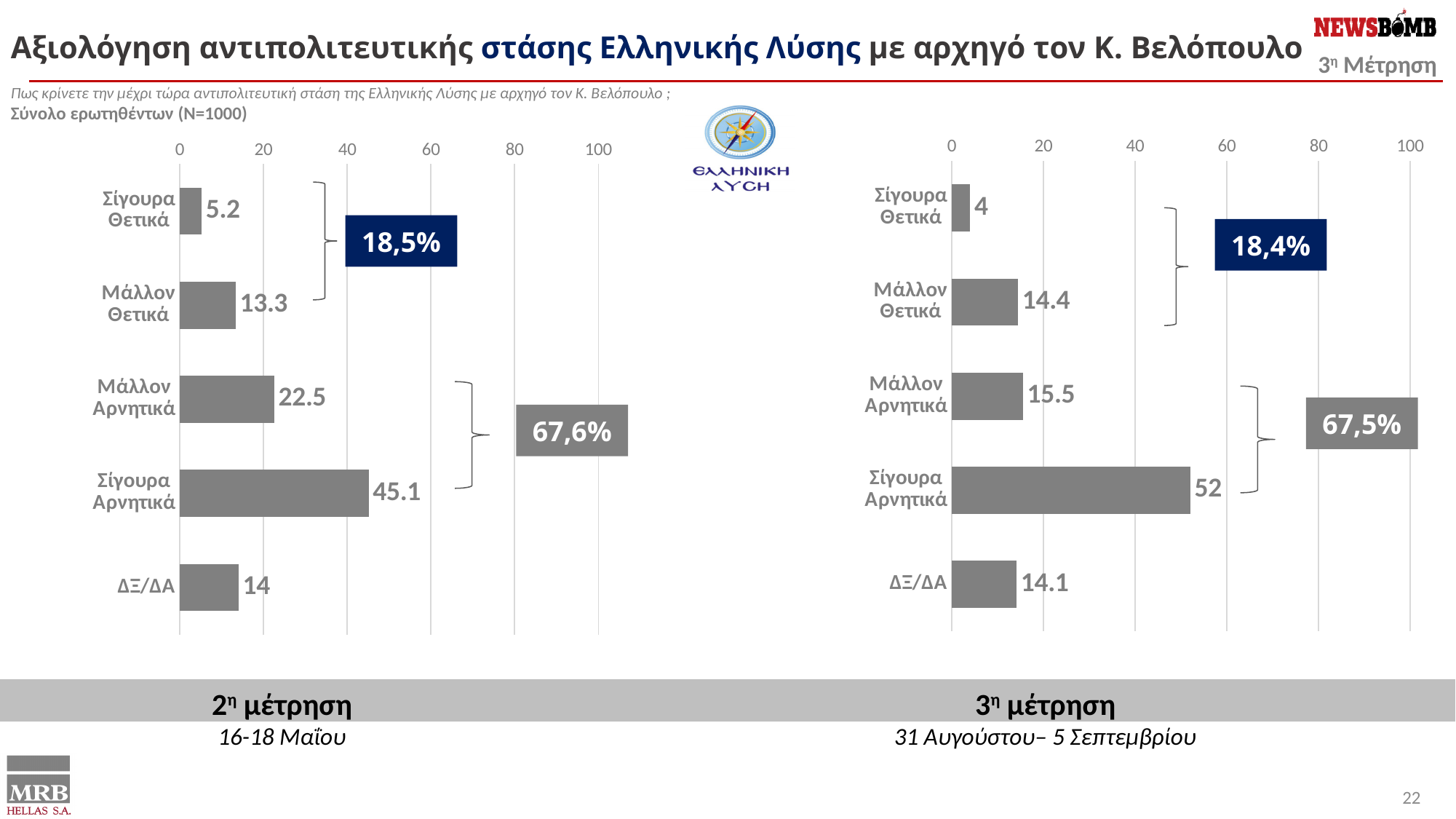
In the right chart (3η μέτρηση), what is the value for Σίγουρα Θετικά? 4 In the right chart (3η μέτρηση), what is the value for Μάλλον Θετικά? 14.4 In the right chart (3η μέτρηση), what is the difference between Σίγουρα Αρνητικά and ΔΞ/ΔΑ? 37.9 In the left chart (2η μέτρηση), what is the difference between Σίγουρα Αρνητικά and Μάλλον Αρνητικά? 22.6 In the right chart (3η μέτρηση), which category has the lowest value? Σίγουρα Θετικά In the left chart (2η μέτρηση), which category has the highest value? Σίγουρα Αρνητικά In the right chart (3η μέτρηση), is the value for Σίγουρα Αρνητικά greater or less than 40? greater In the left chart (2η μέτρηση), which is larger: Μάλλον Θετικά or Μάλλον Αρνητικά? Μάλλον Αρνητικά In the left chart (2η μέτρηση), what is the value for Σίγουρα Αρνητικά? 45.1 How many categories does the left chart (2η μέτρηση) show? 5 What kind of chart is the right chart (3η μέτρηση)? bar chart What combined percentage is shown in the dark blue box for the positive categories in the right chart (3η μέτρηση)? 18,4%